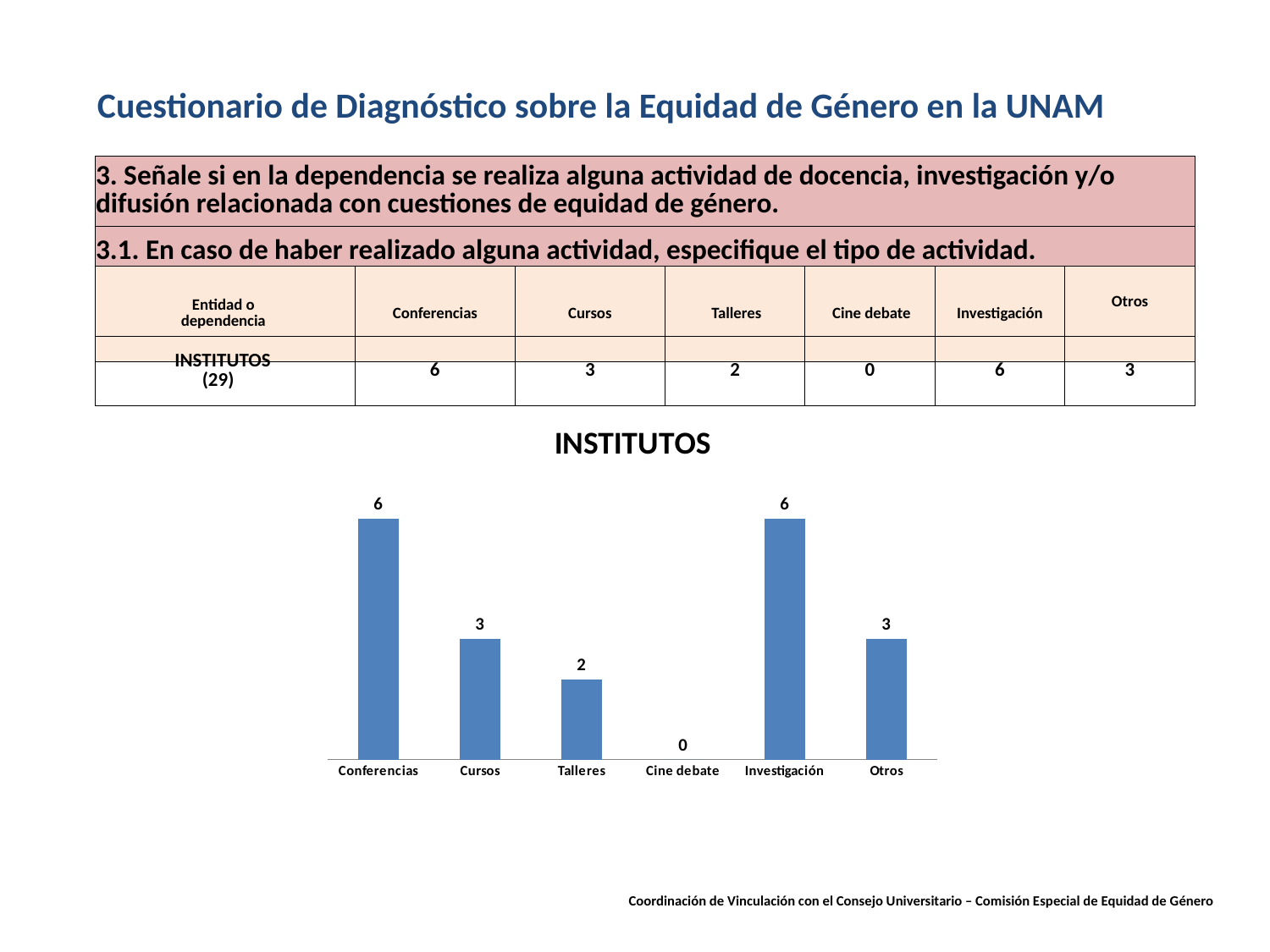
What is the difference between the values for Otros and Cine debate in the INSTITUTOS chart? 3 What is the title of the chart on the slide? INSTITUTOS How many categories are shown in the INSTITUTOS chart? 6 What is the difference between the values for Conferencias and Talleres in the INSTITUTOS chart? 4 What is the value for Conferencias in the INSTITUTOS chart? 6 What is the value for Cursos in the INSTITUTOS chart? 3 What is the value for Investigación in the INSTITUTOS chart? 6 What is the value for Talleres in the INSTITUTOS chart? 2 What is the value for Cine debate in the INSTITUTOS chart? 0 Which is larger in the INSTITUTOS chart, Cursos or Talleres? Cursos Which category has the lowest value in the INSTITUTOS chart? Cine debate What kind of chart is the INSTITUTOS chart? Bar chart